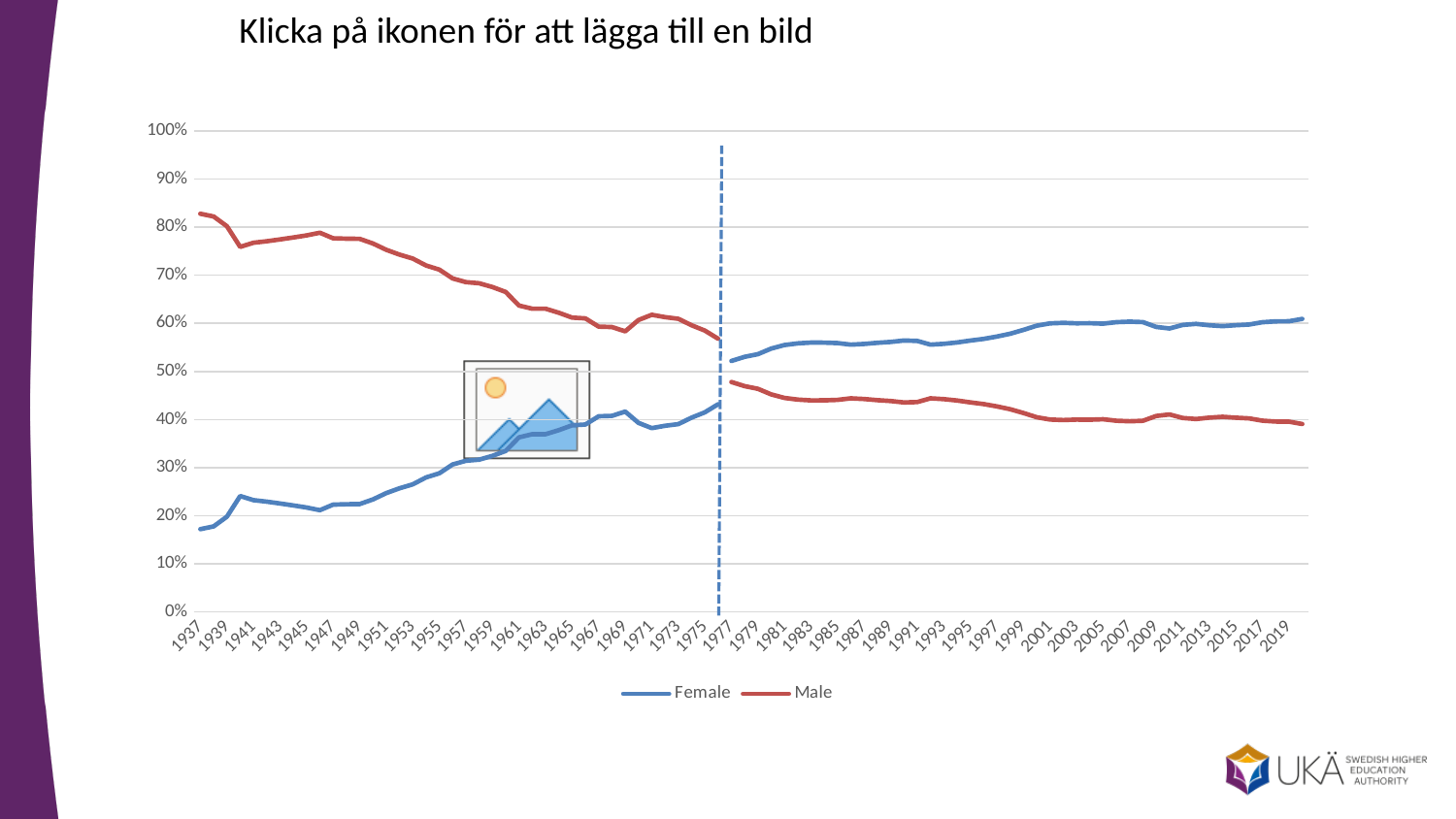
How many series does the legend list? 2 Does the Female series generally rise or fall from 1937 to 2019? Rise What are the two series named in the legend? Female and Male What kind of chart is shown on the slide? Line chart Is the value for Female in 2019 greater or less than 50%? greater Is the value for Female in 1937 greater or less than 20%? less Does the Male series generally rise or fall from 1937 to 2019? Fall Which series is drawn in blue? Female Is the value for Male in 1937 greater or less than 80%? greater In 1937, which series has the higher value, Female or Male? Male In 2019, which series has the higher value, Female or Male? Female